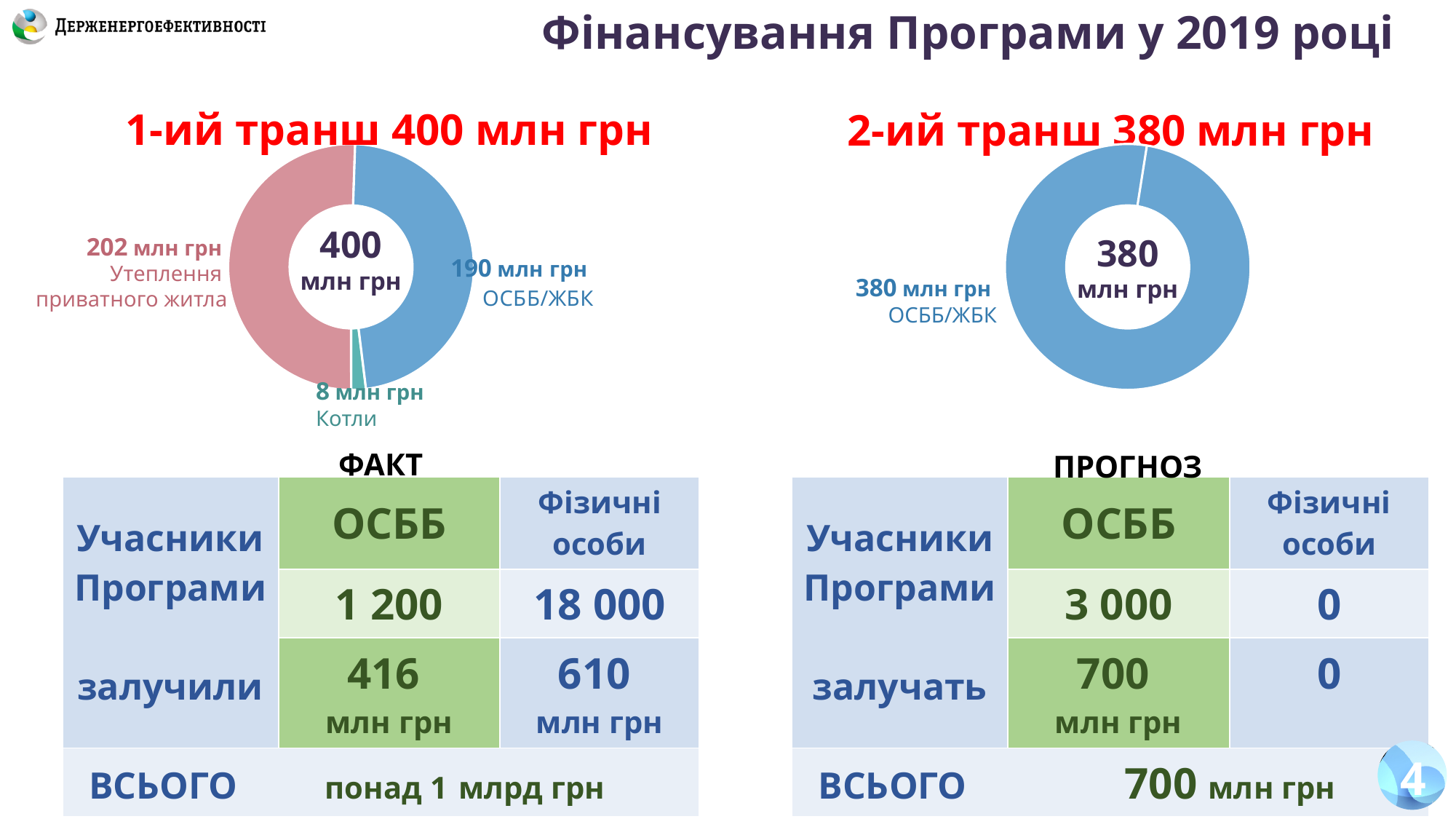
In the chart titled "1-ий транш 400 млн грн", what is the value for Котли? 8 млн грн What kind of chart is the chart titled "1-ий транш 400 млн грн"? Donut (pie) chart In the chart titled "1-ий транш 400 млн грн", what is the difference between Утеплення приватного житла and ОСББ/ЖБК? 12 млн грн In the chart titled "2-ий транш 380 млн грн", what is the value for ОСББ/ЖБК? 380 млн грн What total value is printed in the centre of the chart titled "2-ий транш 380 млн грн"? 380 млн грн How many labelled categories does the chart titled "1-ий транш 400 млн грн" show? 3 In the chart titled "1-ий транш 400 млн грн", which category has the smallest value? Котли In the chart titled "1-ий транш 400 млн грн", which is larger: ОСББ/ЖБК or Котли? ОСББ/ЖБК In the chart titled "1-ий транш 400 млн грн", what is the value for ОСББ/ЖБК? 190 млн грн In the chart titled "1-ий транш 400 млн грн", which category has the largest value? Утеплення приватного житла In the chart titled "1-ий транш 400 млн грн", what is the value for Утеплення приватного житла? 202 млн грн What total value is printed in the centre of the chart titled "1-ий транш 400 млн грн"? 400 млн грн